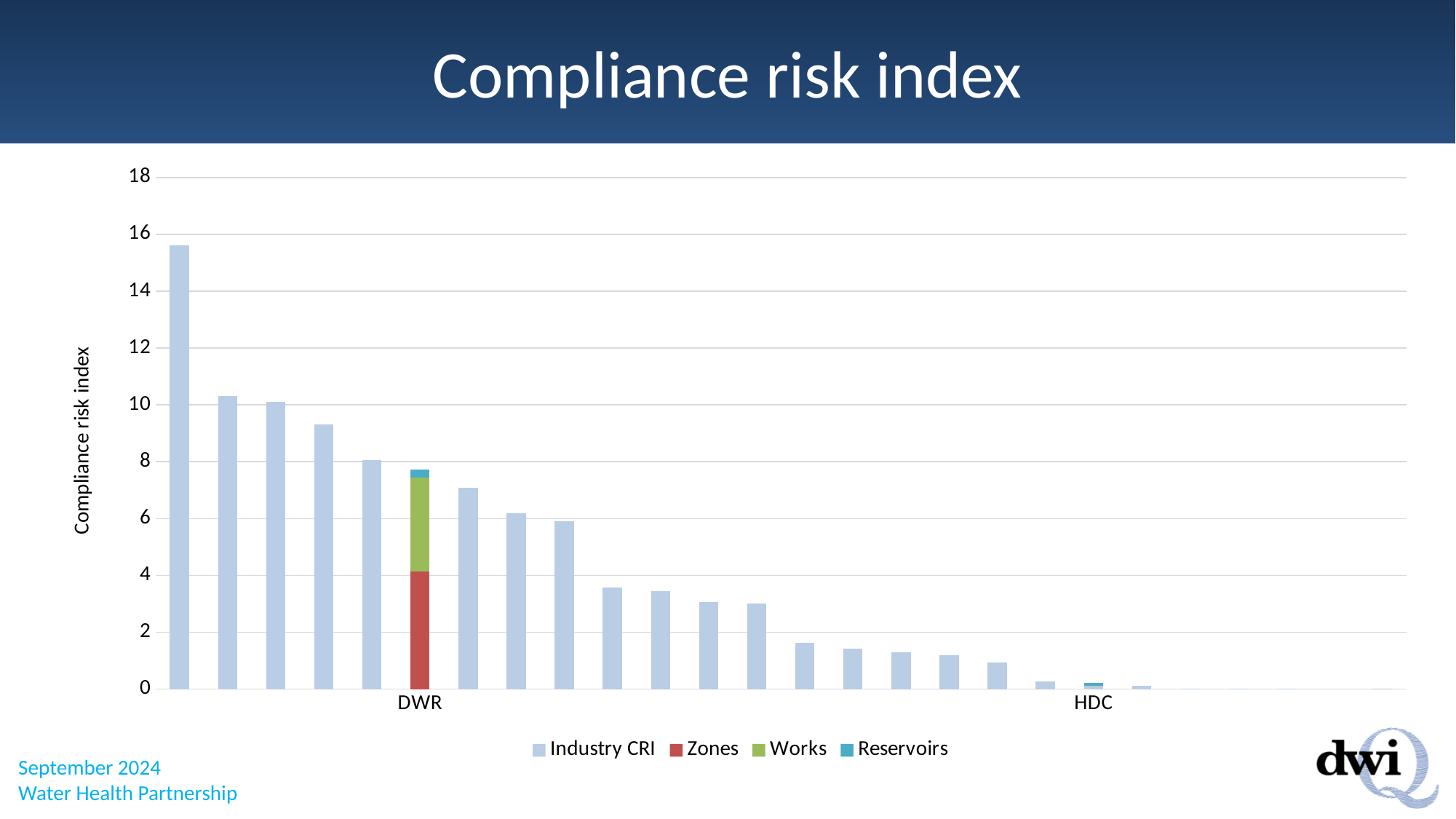
Is the value for HDC greater or less than 2? less What kind of chart is shown on the slide? bar chart Is the total value for DWR greater or less than 6? greater What is the title of the chart? Compliance risk index Is the tallest bar on the chart greater or less than 14? greater Which of the two labelled categories, DWR or HDC, has the lower value? HDC How many series does the legend list? 4 Which has the larger compliance risk index, DWR or HDC? DWR Do the bar values rise or fall from left to right along the x axis? fall Which series in the legend is shown in red? Zones